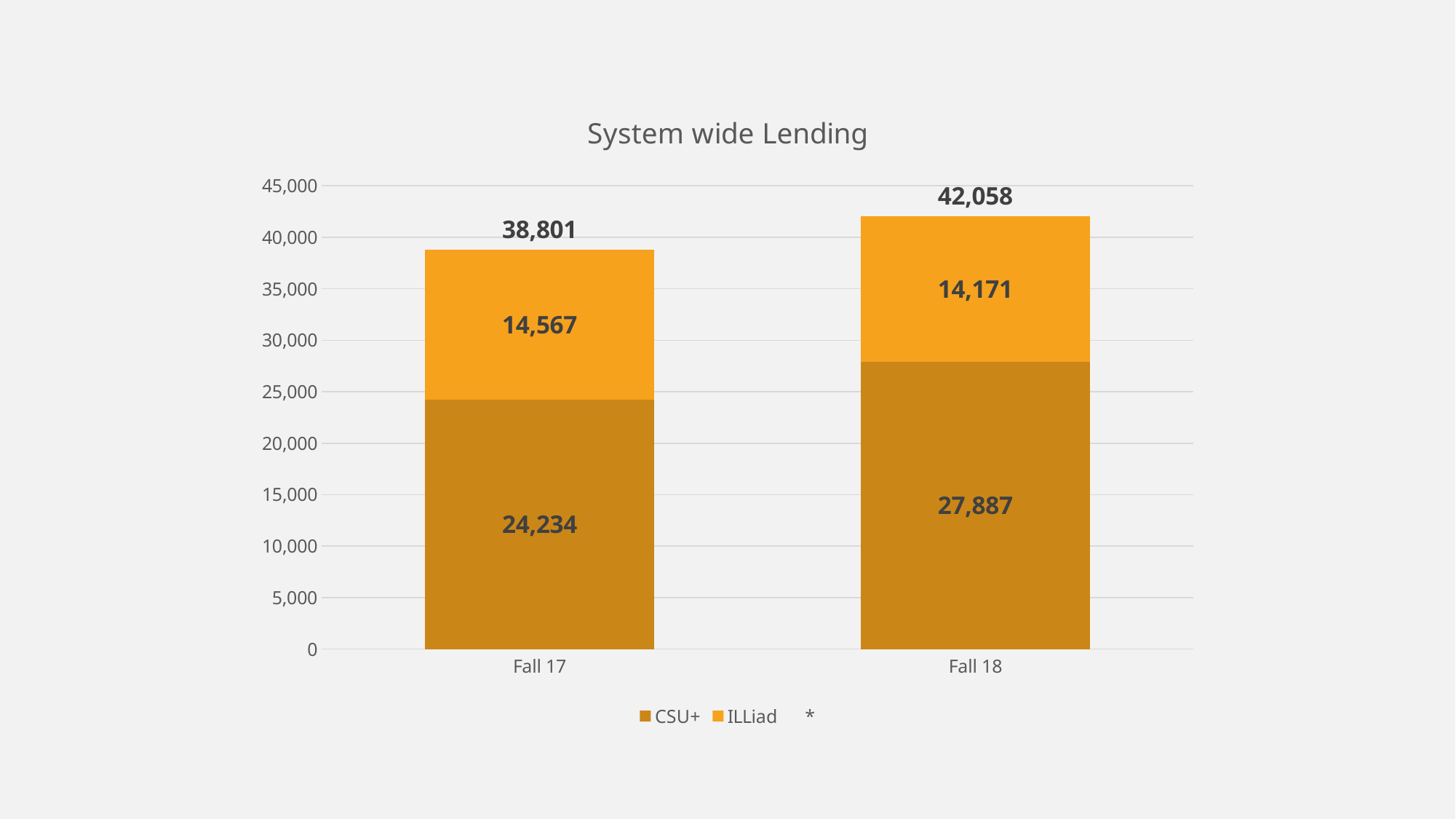
What is the title of the chart? System wide Lending What kind of chart is shown? Stacked bar chart What is the ILLiad value for Fall 17? 14,567 How many series does the legend list? 3 What is the difference between the CSU+ values for Fall 18 and Fall 17? 3,653 Which category has the higher total, Fall 17 or Fall 18? Fall 18 What is the CSU+ value for Fall 18? 27,887 What is the total of the stacked bar for Fall 18? 42,058 What is the CSU+ value for Fall 17? 24,234 What is the difference between the totals for Fall 18 and Fall 17? 3,257 What is the total of the stacked bar for Fall 17? 38,801 What is the ILLiad value for Fall 18? 14,171